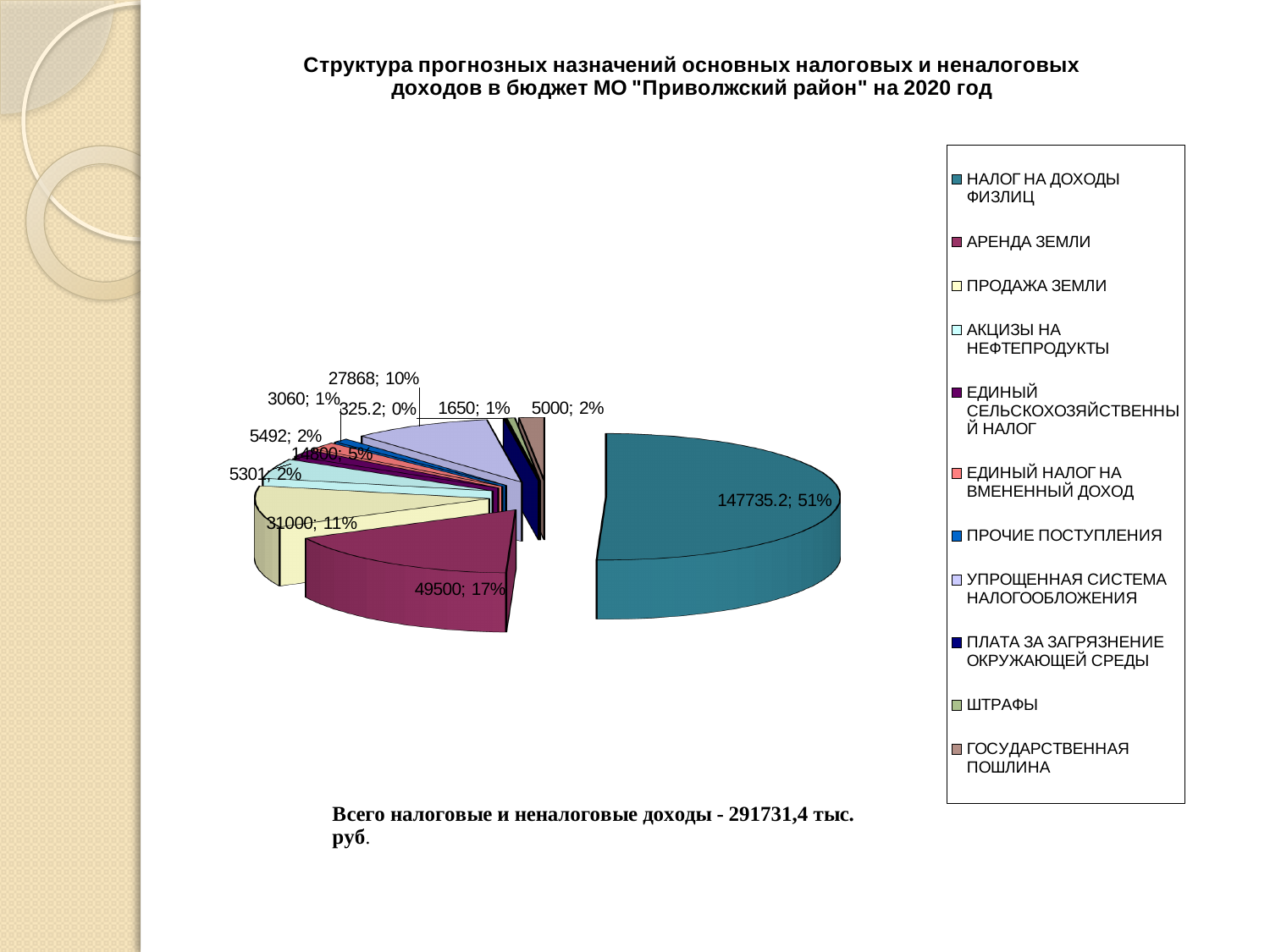
What is the difference between the values for АРЕНДА ЗЕМЛИ and ПРОДАЖА ЗЕМЛИ? 18500 What share of the pie does НАЛОГ НА ДОХОДЫ ФИЗЛИЦ represent? 51% What share of the pie does АРЕНДА ЗЕМЛИ represent? 17% Which category has the largest slice of the pie chart? НАЛОГ НА ДОХОДЫ ФИЗЛИЦ What value is shown for АРЕНДА ЗЕМЛИ? 49500 How many categories does the legend of the pie chart list? 11 What share of the pie does УПРОЩЕННАЯ СИСТЕМА НАЛОГООБЛОЖЕНИЯ represent? 10% What value is shown for НАЛОГ НА ДОХОДЫ ФИЗЛИЦ? 147735.2 What value is shown for ПРОДАЖА ЗЕМЛИ? 31000 What kind of chart is shown on the slide? Pie chart According to the text below the chart, what is the total of tax and non-tax revenues? 291731,4 тыс. руб. Which is larger, the value for АРЕНДА ЗЕМЛИ or the value for ПРОДАЖА ЗЕМЛИ? АРЕНДА ЗЕМЛИ